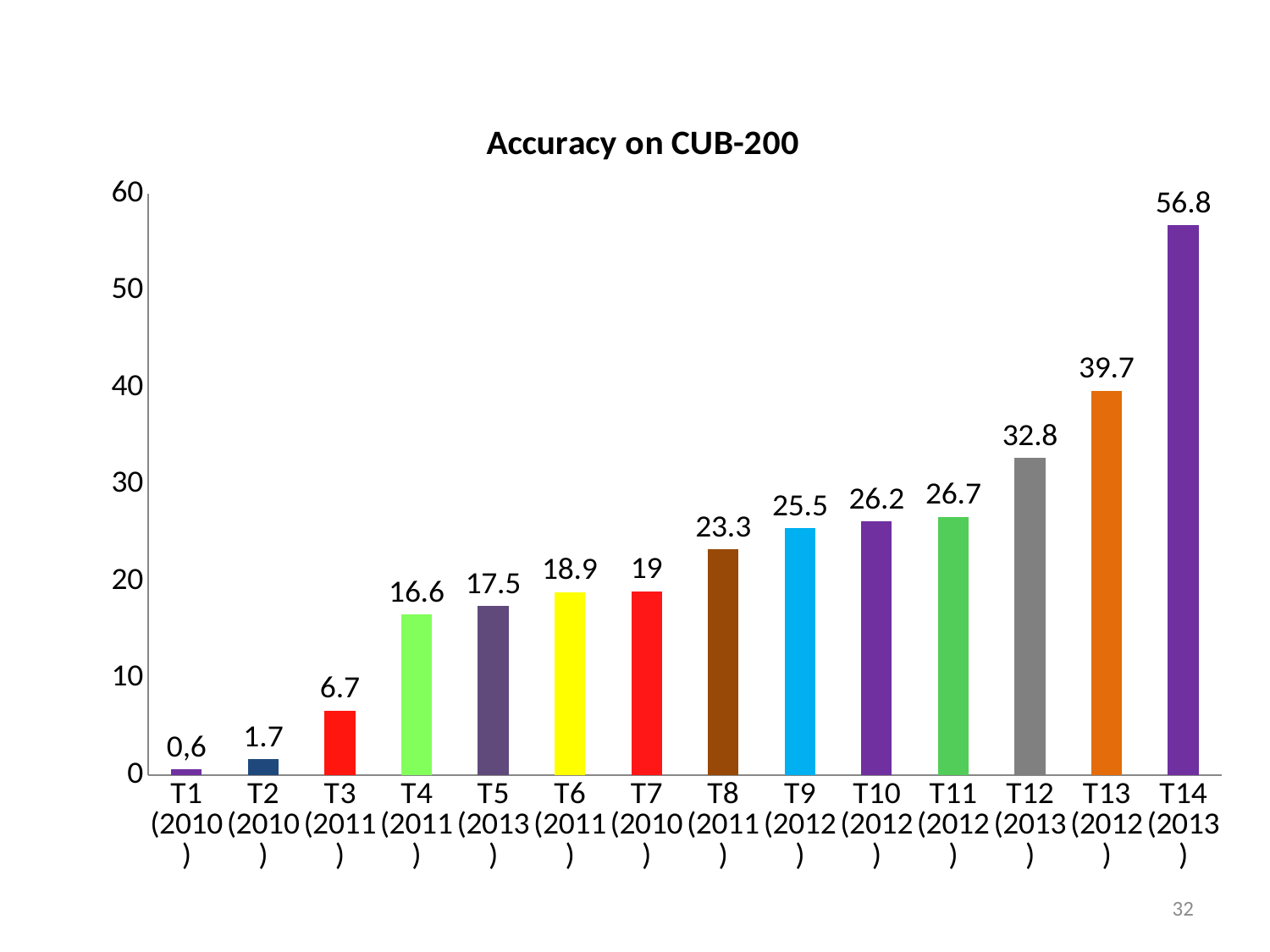
What is the difference between the accuracy of T12 and T9? 7.3 Which has a higher accuracy, T7 or T11? T11 Which category has the highest accuracy on CUB-200? T14 (2013) What is the accuracy value shown for T8 (2011)? 23.3 Is the value for T13 greater or less than 30? greater What is the difference between the accuracy of T14 and T13? 17.1 How many bars are shown in the chart? 14 What is the accuracy value shown for T14 (2013)? 56.8 Which category has the lowest accuracy on CUB-200? T1 (2010) What is the accuracy value shown for T3 (2011)? 6.7 What kind of chart is shown on the slide? Bar chart Do the values rise or fall from T1 to T14 along the x axis? Rise